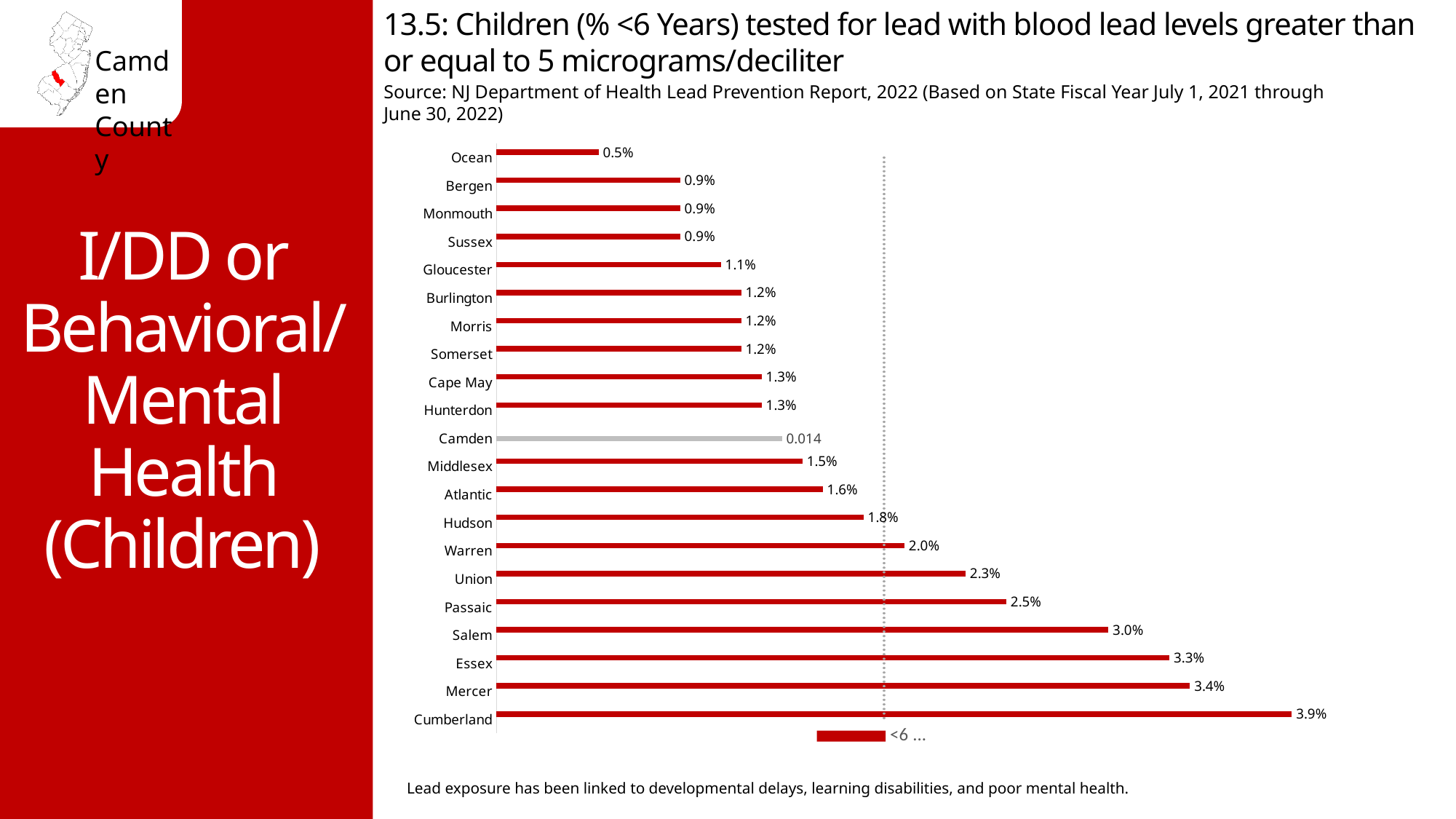
Which county has the highest value? Cumberland Which has a larger value, Salem or Passaic? Salem Which county's bar is colored grey instead of red? Camden What is the value for Cumberland? 3.9% What kind of chart is shown on the slide? Bar chart What value is labeled on the Camden bar? 0.014 Do the values increase or decrease going from the top bar (Ocean) to the bottom bar (Cumberland)? Increase Which county has the lowest value? Ocean What is the difference between the values for Mercer and Essex? 0.1% What is the value for Ocean? 0.5% How many counties are shown in the chart? 21 What is the value for Hudson? 1.8%